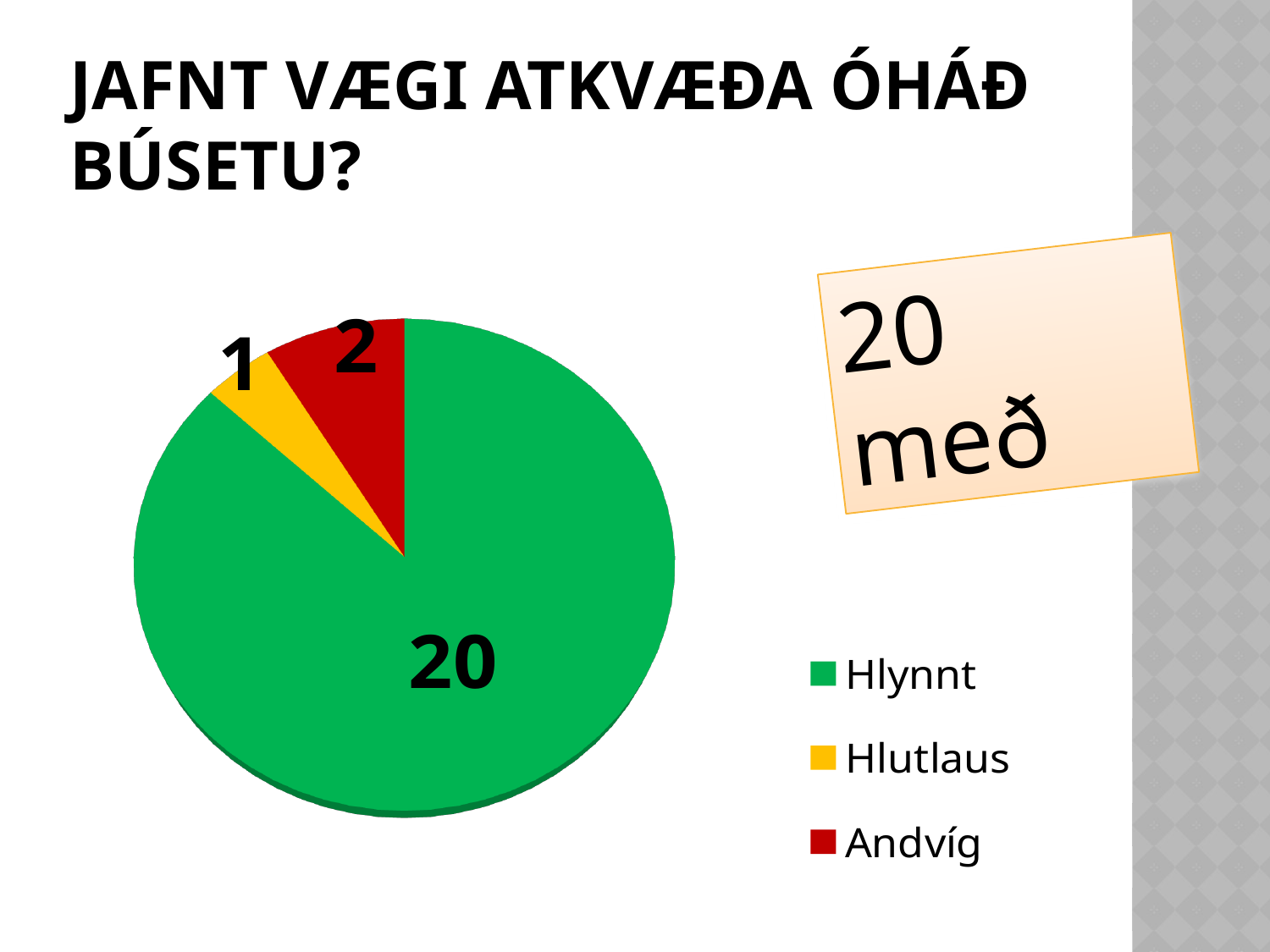
What is the difference between the values for Hlynnt and Andvíg? 18 Which category has the smallest slice? Hlutlaus What kind of chart is shown on the slide? pie chart How many categories does the pie chart have? 3 What is the value for Hlynnt? 20 Which category has the largest slice? Hlynnt Which is larger, the value for Andvíg or the value for Hlutlaus? Andvíg What is the value for Hlutlaus? 1 What is the total of all slices in the pie chart? 23 Which legend entry is shown in red? Andvíg What colour is the Hlynnt slice? green What is the value for Andvíg? 2